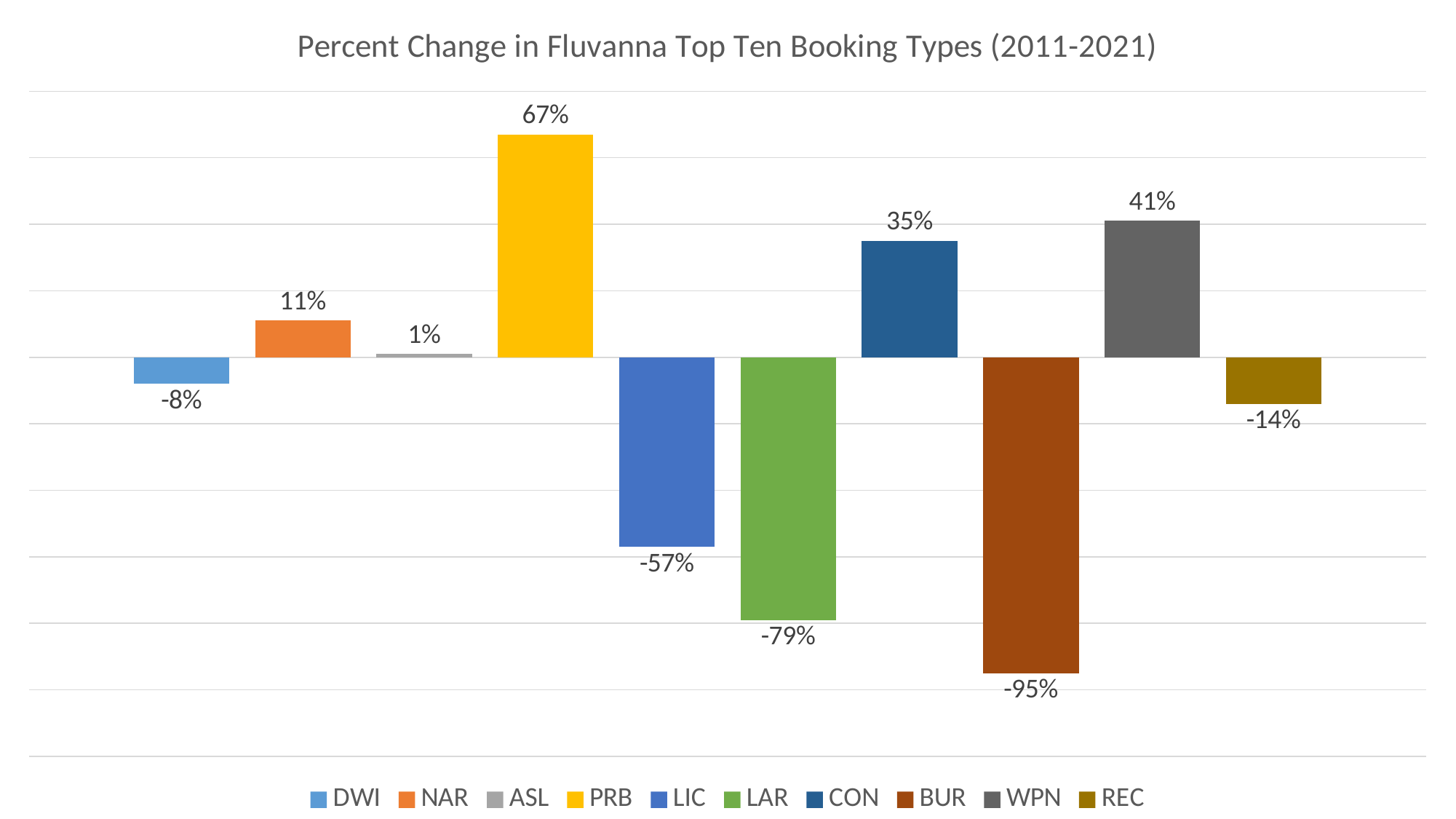
How many booking types are shown in the chart? 10 Which has a larger percent change, LIC or REC? REC What is the percent change for DWI? -8% Which has a larger percent change, NAR or ASL? NAR What is the difference between the percent change for WPN and the percent change for CON? 6% Which booking type has the lowest percent change? BUR What is the percent change for BUR? -95% What is the percent change for LAR? -79% Which booking type has the highest percent change? PRB What is the title of the chart? Percent Change in Fluvanna Top Ten Booking Types (2011-2021) What type of chart is shown on the slide? Bar chart What is the percent change for PRB? 67%